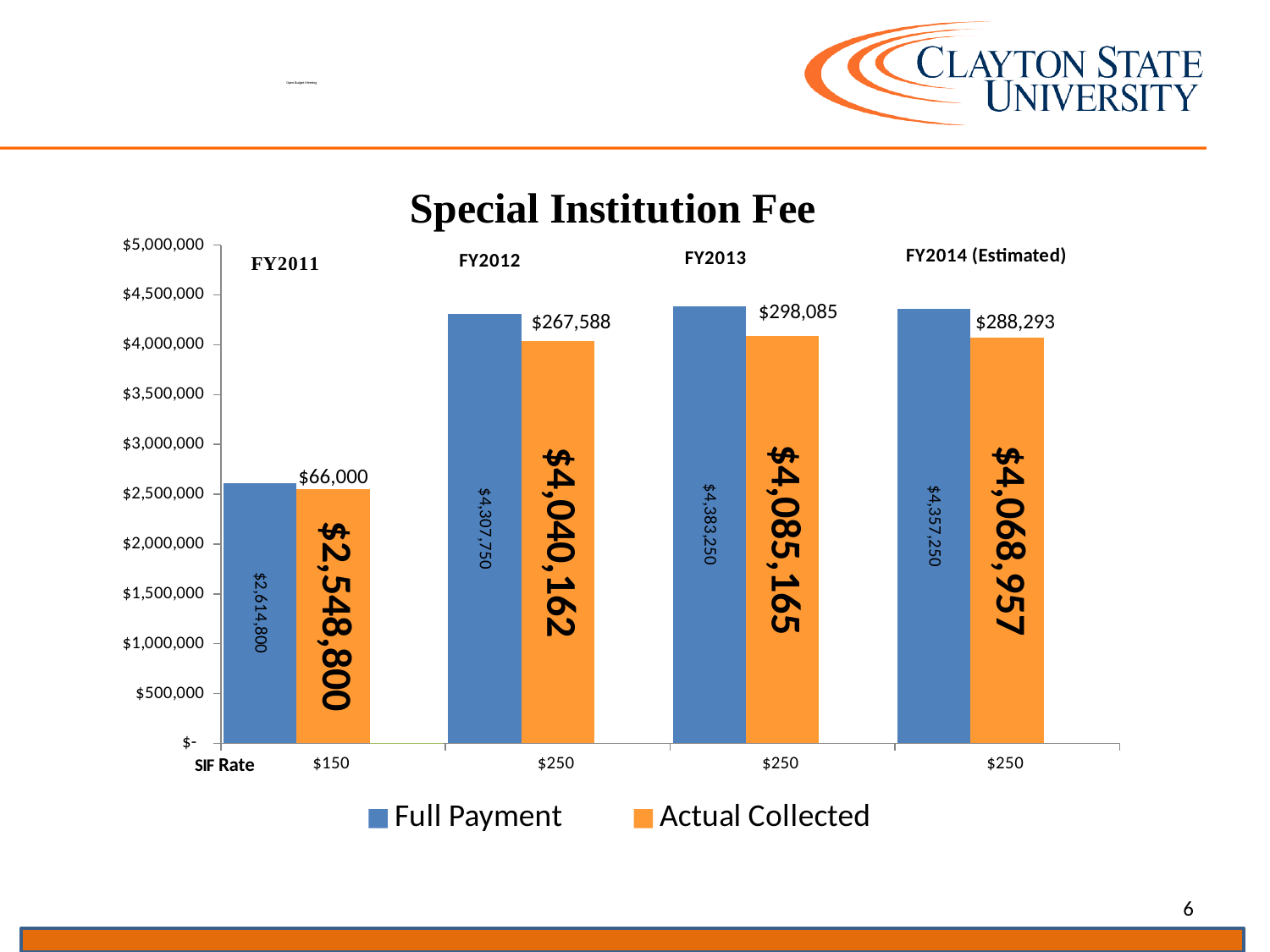
Which fiscal year has the highest Full Payment value? FY2013 What is the difference between Full Payment and Actual Collected in FY2011? $66,000 How many series does the legend list? 2 Which fiscal year has the lowest Actual Collected value? FY2011 What is the title of the chart? Special Institution Fee What is the Actual Collected value for FY2011? $2,548,800 How many fiscal years are shown on the chart? 4 What type of chart is shown on the slide? bar chart What is the Full Payment value for FY2012? $4,307,750 What is the Full Payment value for FY2014 (Estimated)? $4,357,250 Is the Actual Collected value for FY2012 greater or less than $4,000,000? greater What is the Actual Collected value for FY2013? $4,085,165